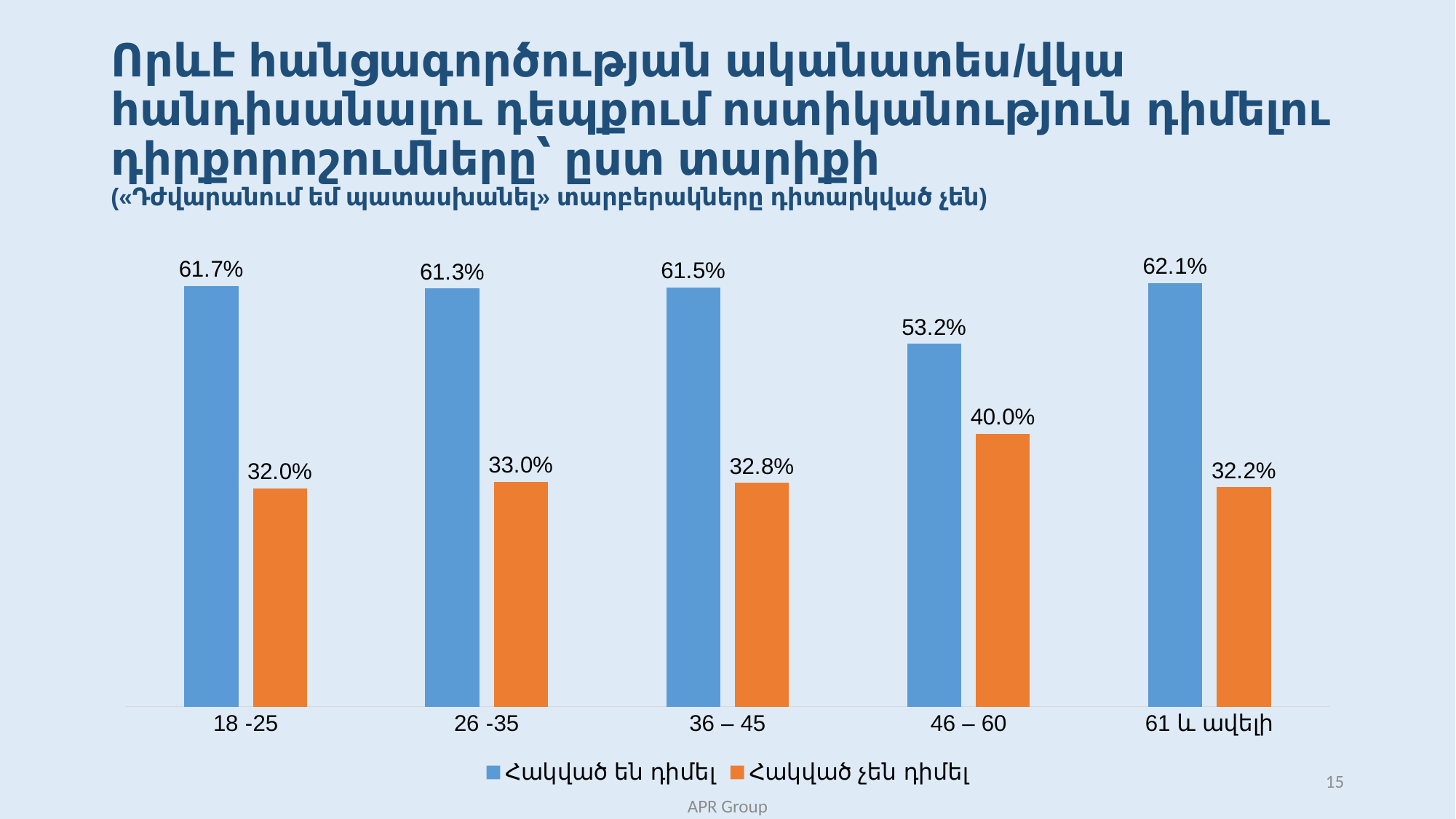
Which age group has the highest value for "Հակված են դիմել"? 61 և ավելի What type of chart is shown on the slide? bar chart What is the value of "Հակված չեն դիմել" for the 46 – 60 age group? 40.0% What is the value of "Հակված են դիմել" for the 61 և ավելի age group? 62.1% For the 46 – 60 age group, which is larger: "Հակված են դիմել" or "Հակված չեն դիմել"? Հակված են դիմել What colour are the bars for the "Հակված չեն դիմել" series? orange How many age categories are shown on the x axis? 5 How many series does the legend list? 2 What is the value of "Հակված են դիմել" for the 18 -25 age group? 61.7% Which age group has the lowest value for "Հակված են դիմել"? 46 – 60 What is the difference between "Հակված են դիմել" and "Հակված չեն դիմել" for the 36 – 45 age group? 28.7% Which age group has the highest value for "Հակված չեն դիմել"? 46 – 60